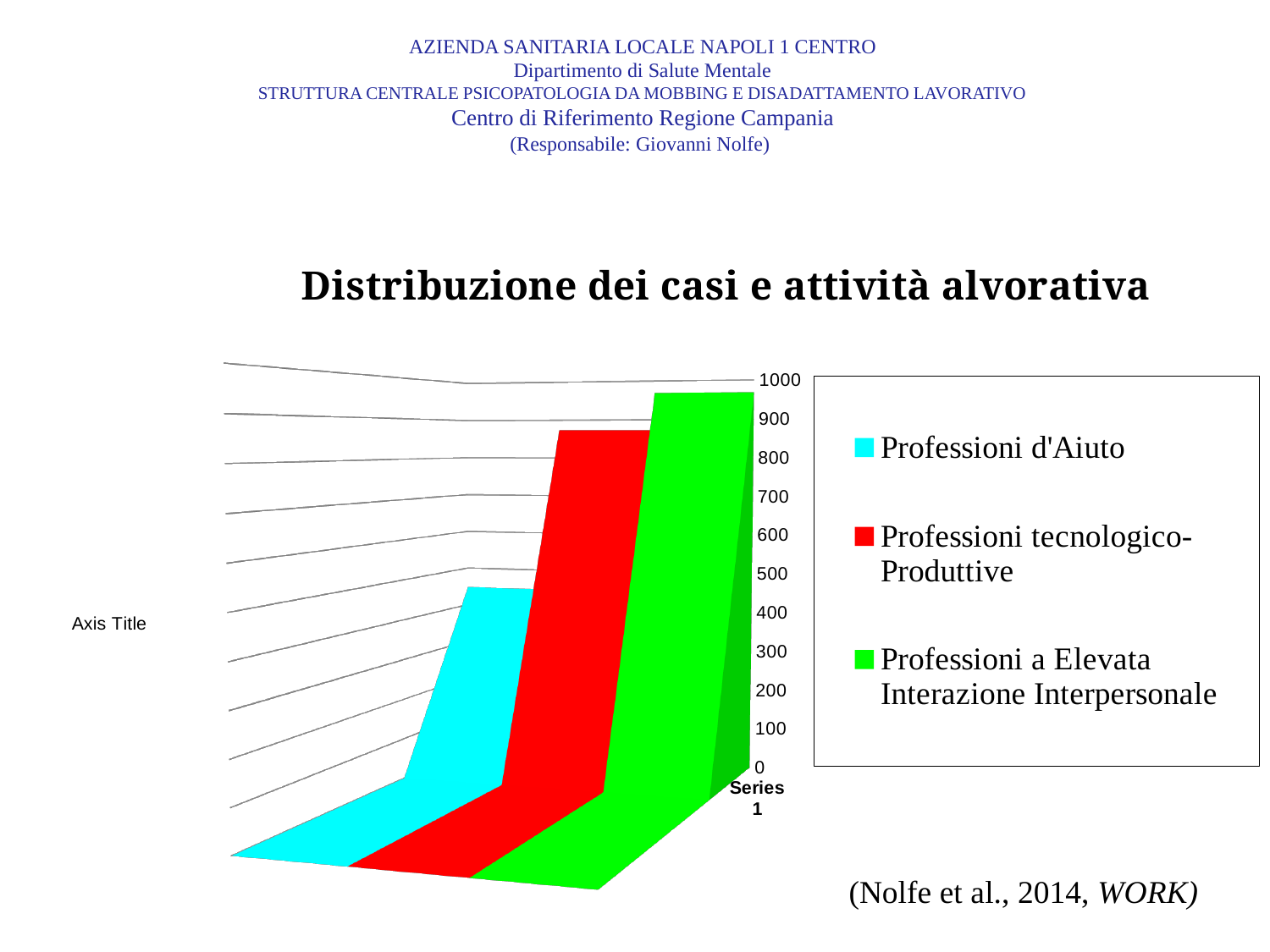
Which is larger, the value for Professioni tecnologico-Produttive or the value for Professioni a Elevata Interazione Interpersonale? Professioni a Elevata Interazione Interpersonale Which series has the lowest value? Professioni d'Aiuto What colour represents Professioni tecnologico-Produttive in the legend? red What is the title of the chart? Distribuzione dei casi e attività alvorativa Which is larger, the value for Professioni d'Aiuto or the value for Professioni tecnologico-Produttive? Professioni tecnologico-Produttive Is the value for Professioni d'Aiuto greater or less than 600? less Is the value for Professioni a Elevata Interazione Interpersonale greater or less than 800? greater What kind of chart is shown on the slide? area chart Is the value for Professioni d'Aiuto greater or less than 300? greater How many series does the legend list? 3 Which series has the highest value? Professioni a Elevata Interazione Interpersonale